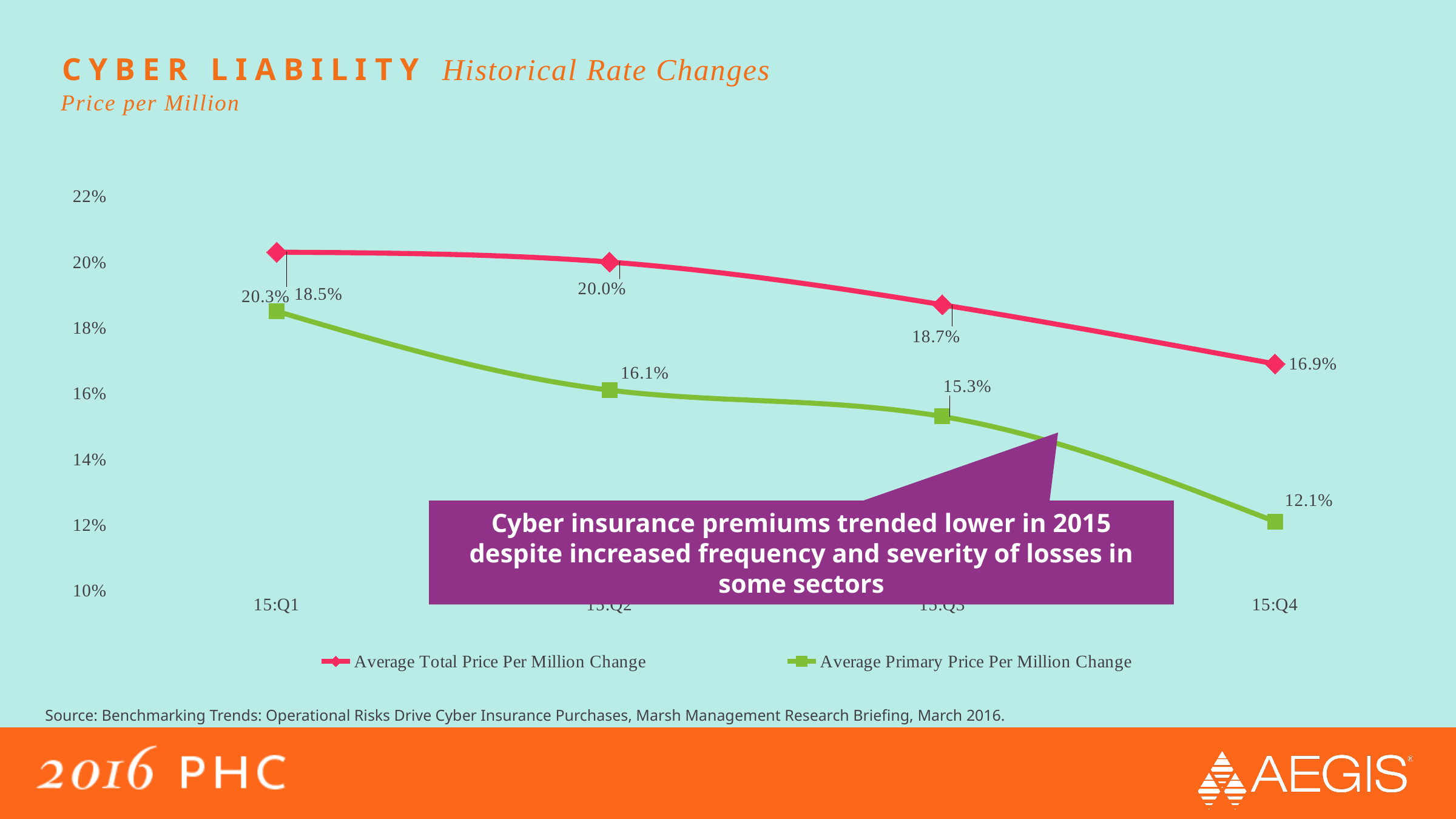
What is the Average Total Price Per Million Change for 15:Q1? 20.3% What is the Average Primary Price Per Million Change for 15:Q4? 12.1% What is the Average Total Price Per Million Change for 15:Q4? 16.9% How many series does the legend list? 2 How many quarters are plotted along the x axis? 4 In which quarter is the Average Primary Price Per Million Change lowest? 15:Q4 Do the values of the Average Primary Price Per Million Change rise or fall from 15:Q1 to 15:Q4? fall What type of chart is shown on the slide? line chart Which series is shown in green in the legend? Average Primary Price Per Million Change What is the Average Primary Price Per Million Change for 15:Q1? 18.5% What is the difference between the Average Total Price Per Million Change and the Average Primary Price Per Million Change in 15:Q4? 4.8% In which quarter is the Average Total Price Per Million Change highest? 15:Q1